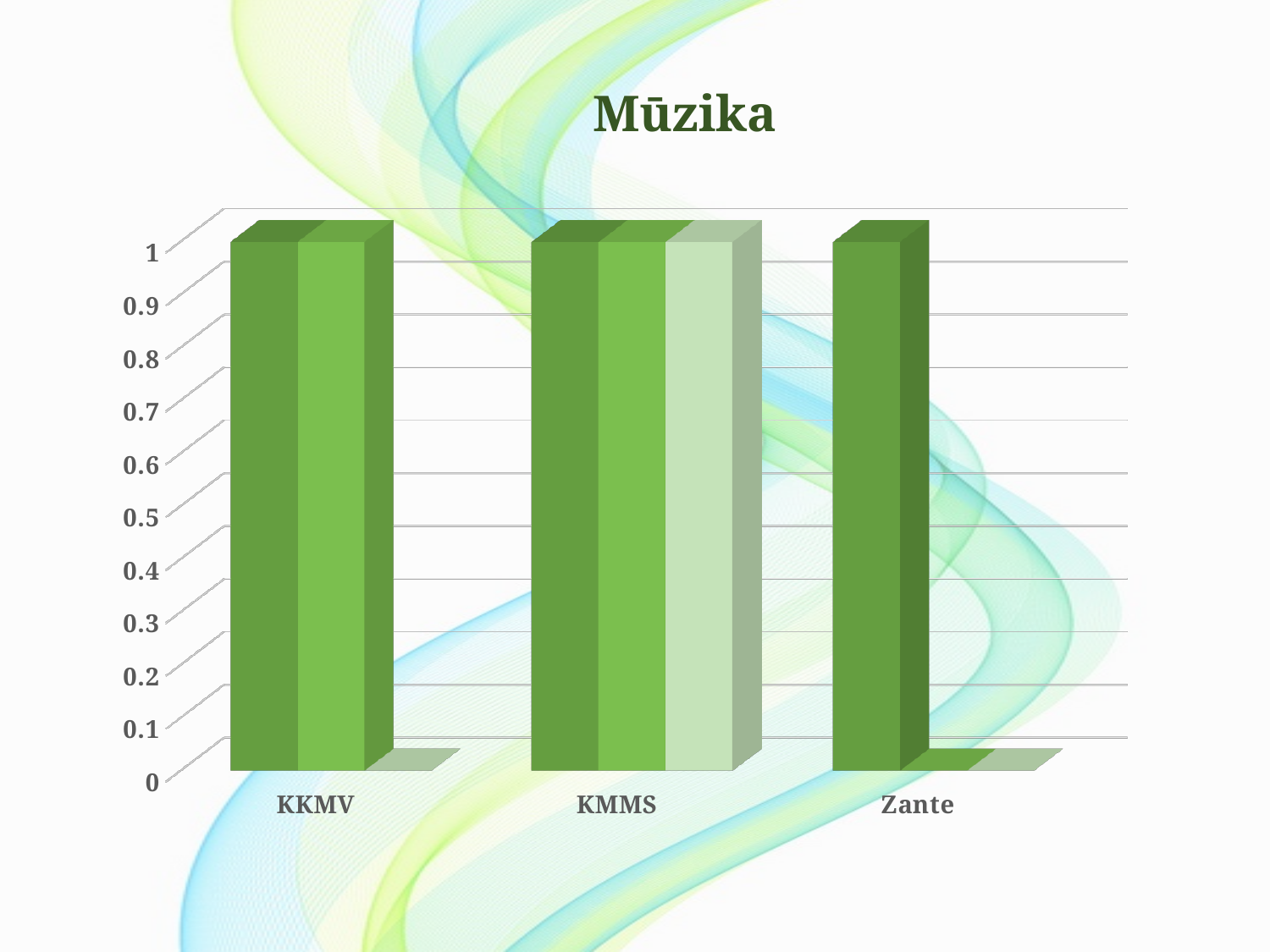
Is the value for KKMV greater or less than 0.9? greater What value does the dark green bar for Zante reach? 1 What are the category labels on the x axis of the chart? KKMV, KMMS, Zante What is the highest value shown on the y axis of the chart? 1 How many categories are shown on the x axis of the chart? 3 How many bars are drawn for the Zante category? 1 How many bars are drawn for the KMMS category? 3 What is the title of the chart? Mūzika What value do the bars for KMMS reach? 1 Is the value for Zante greater or less than 0.5? greater What value does the dark green bar for KKMV reach? 1 What kind of chart is shown on the slide? bar chart